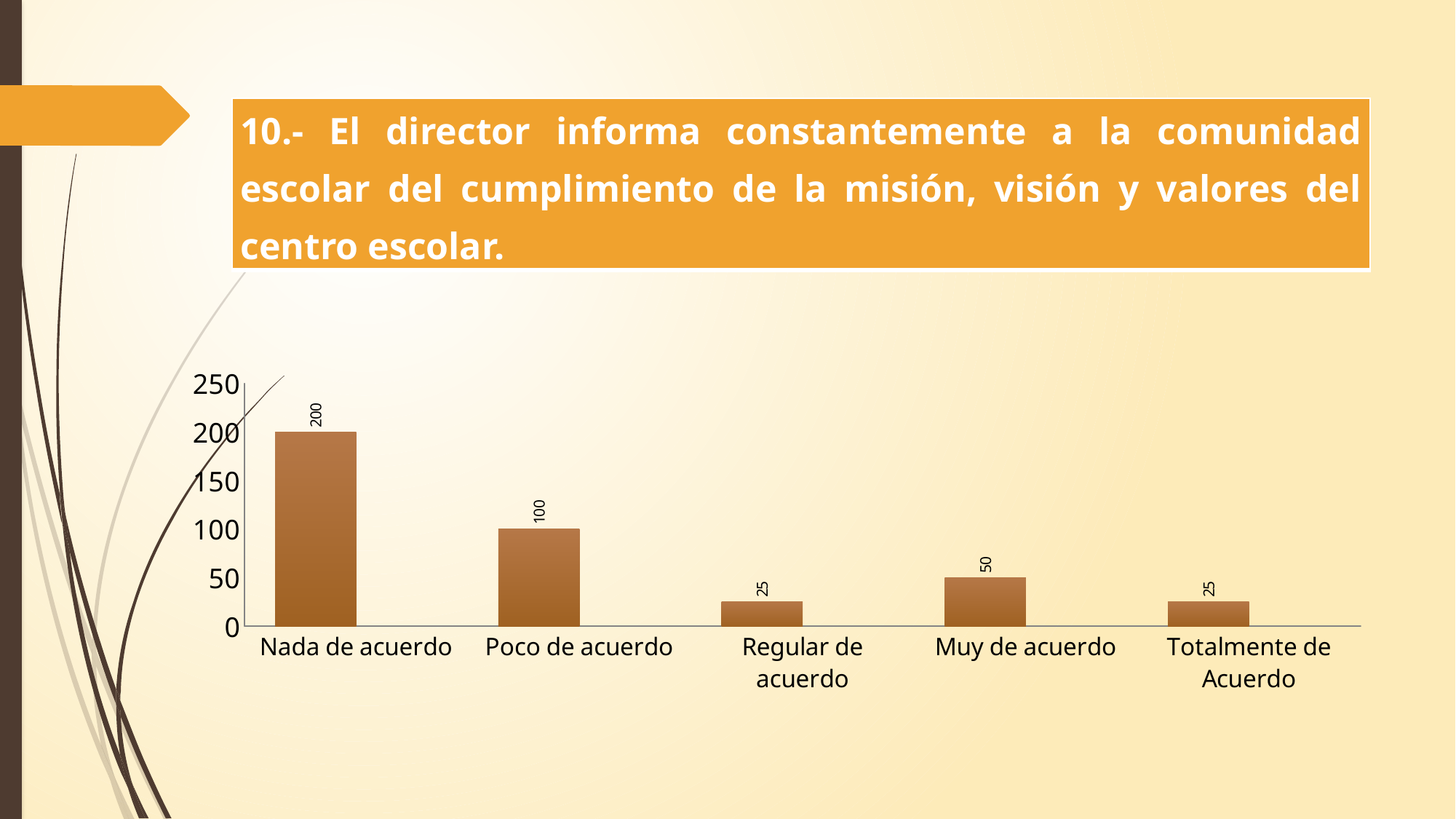
What is the value for Totalmente de Acuerdo? 25 What is the highest value shown on the vertical axis? 250 What is the value for Poco de acuerdo? 100 Which is larger, the value for Poco de acuerdo or the value for Muy de acuerdo? Poco de acuerdo What is the value for Muy de acuerdo? 50 What is the value for Nada de acuerdo? 200 How many categories are shown on the x axis? 5 What kind of chart is shown on the slide? bar chart Which category has the highest value? Nada de acuerdo What is the difference between the values for Nada de acuerdo and Poco de acuerdo? 100 What is the difference between the values for Muy de acuerdo and Regular de acuerdo? 25 Is the value for Nada de acuerdo greater or less than 150? greater